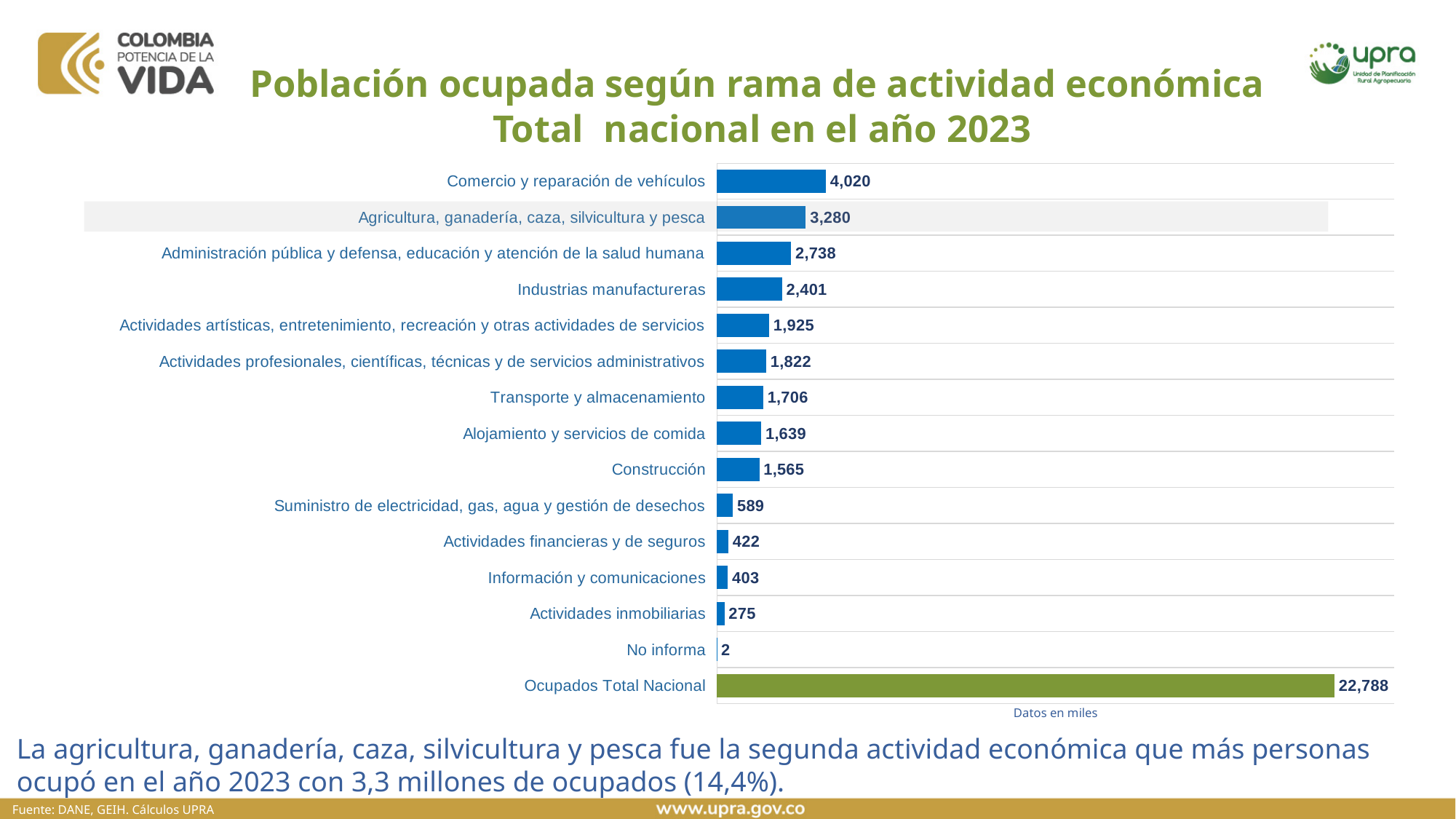
How many bars are shown in the chart? 15 Which category has the lowest value? No informa What is the value for Construcción? 1,565 What is the value for Comercio y reparación de vehículos? 4,020 What unit note is printed below the chart? Datos en miles What is the value for Agricultura, ganadería, caza, silvicultura y pesca? 3,280 What type of chart is shown on the slide? Bar chart What is the value for Ocupados Total Nacional? 22,788 Excluding the Ocupados Total Nacional bar, which economic activity has the highest value? Comercio y reparación de vehículos What is the difference between Suministro de electricidad, gas, agua y gestión de desechos and Actividades financieras y de seguros? 167 Which is larger, Transporte y almacenamiento or Alojamiento y servicios de comida? Transporte y almacenamiento What is the difference between Comercio y reparación de vehículos and Agricultura, ganadería, caza, silvicultura y pesca? 740